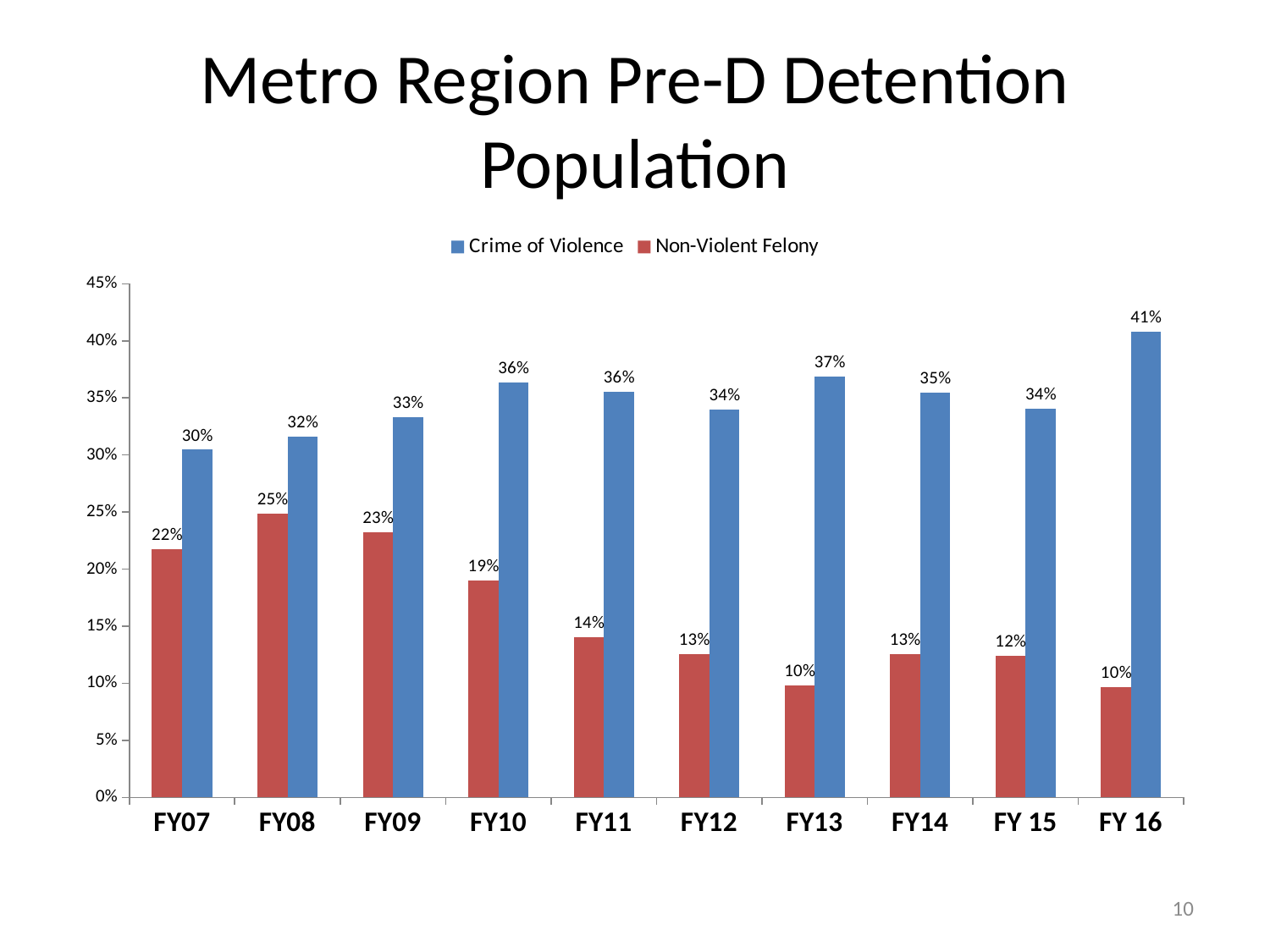
What is the Crime of Violence value for FY10? 36% What is the difference between the Crime of Violence and Non-Violent Felony values in FY13? 27% How many series does the legend list? 2 Which is larger in FY07, the Crime of Violence value or the Non-Violent Felony value? Crime of Violence What is the Crime of Violence value for FY 16? 41% What kind of chart is shown on the slide? Bar chart Does the Non-Violent Felony value rise or fall from FY07 to FY 16? Fall Which fiscal year has the highest Non-Violent Felony value? FY08 Which fiscal year has the highest Crime of Violence value? FY 16 What colour are the Crime of Violence bars? Blue What is the Non-Violent Felony value for FY08? 25% How many fiscal years are shown on the x axis? 10